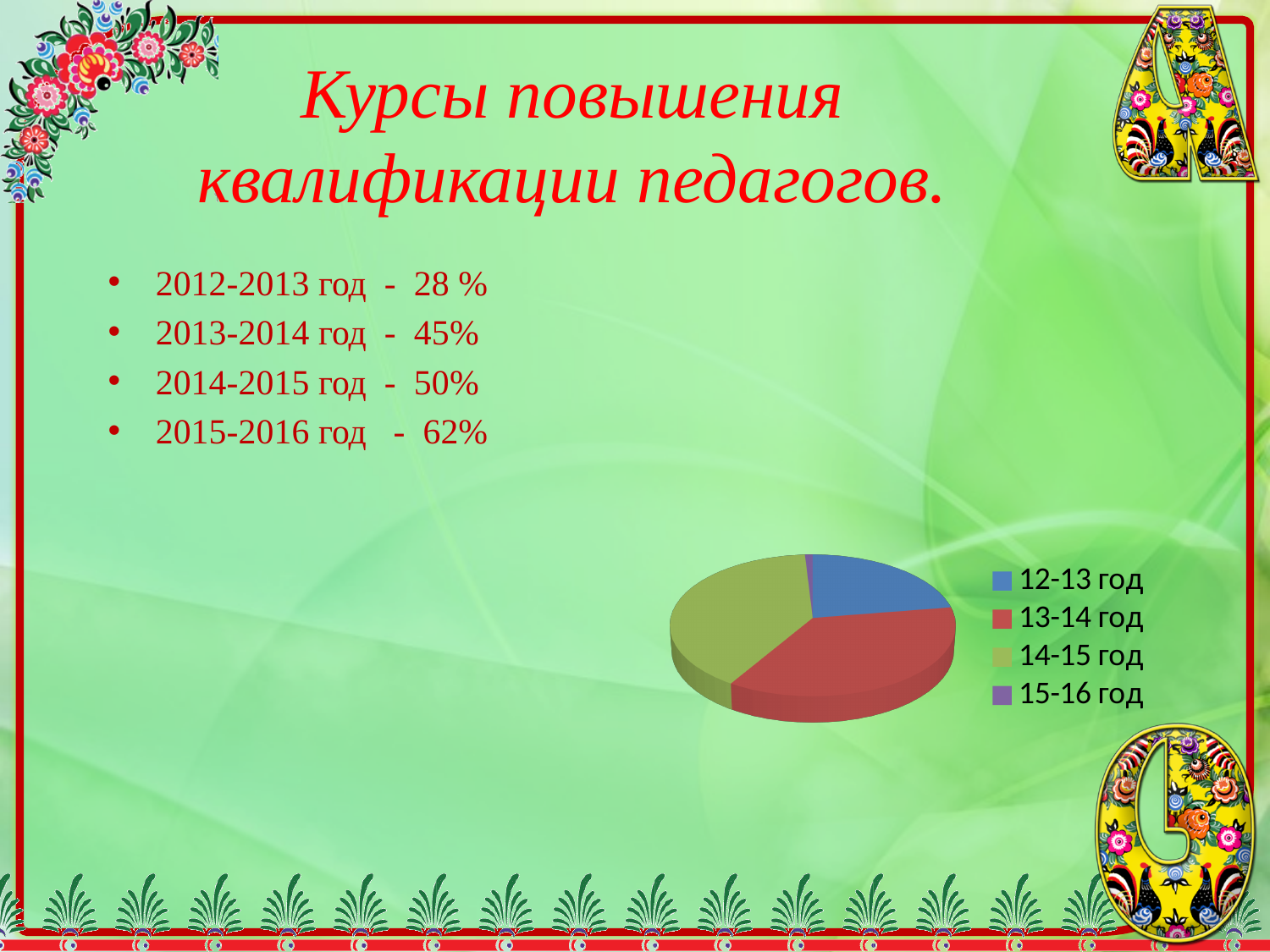
In the pie chart, which slice is larger: 14-15 год or 12-13 год? 14-15 год How many slices does the pie chart have? 4 How many entries does the legend of the pie chart list? 4 In the pie chart, which slice is larger: 12-13 год or 15-16 год? 12-13 год What colour is the slice for 13-14 год in the pie chart? red Which category has the largest slice in the pie chart? 14-15 год Which category has the smallest slice in the pie chart? 15-16 год In the pie chart, which slice is larger: 13-14 год or 12-13 год? 13-14 год What kind of chart is shown on the slide? pie chart Where is the legend placed relative to the pie chart? to the right